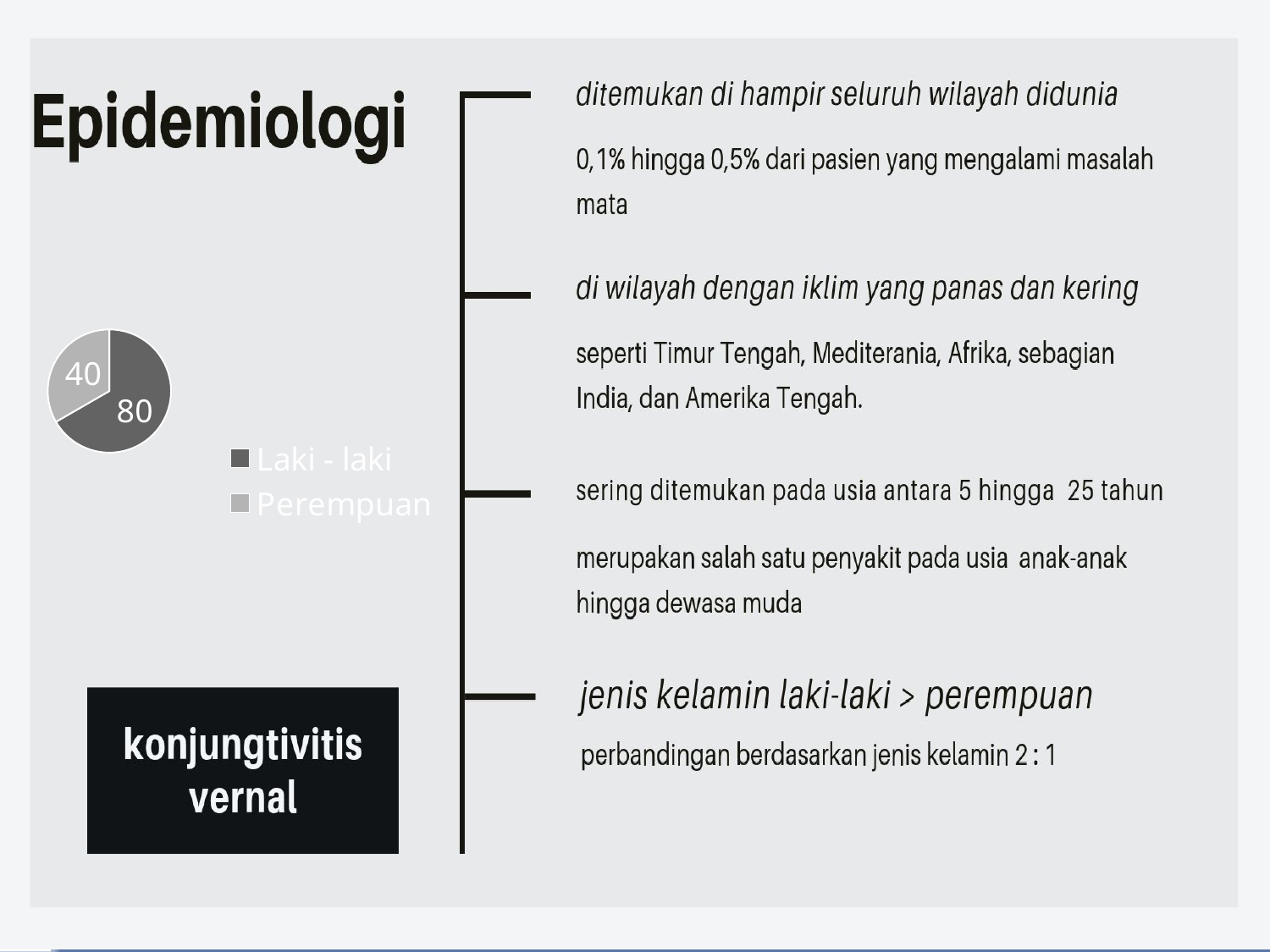
What kind of chart is shown on the slide? pie chart What is the value for Laki - laki in the pie chart? 80 What is the total of the two values shown in the pie chart? 120 Which is larger, the value for Laki - laki or the value for Perempuan? Laki - laki How many slices does the pie chart have? 2 What share of the pie does the Perempuan slice represent? one third What is the value for Perempuan in the pie chart? 40 Which legend entry is shown with the darker colour in the pie chart? Laki - laki Which category has the largest slice in the pie chart? Laki - laki Which category has the smallest slice in the pie chart? Perempuan What is the difference between the values for Laki - laki and Perempuan? 40 How many entries does the legend of the pie chart list? 2